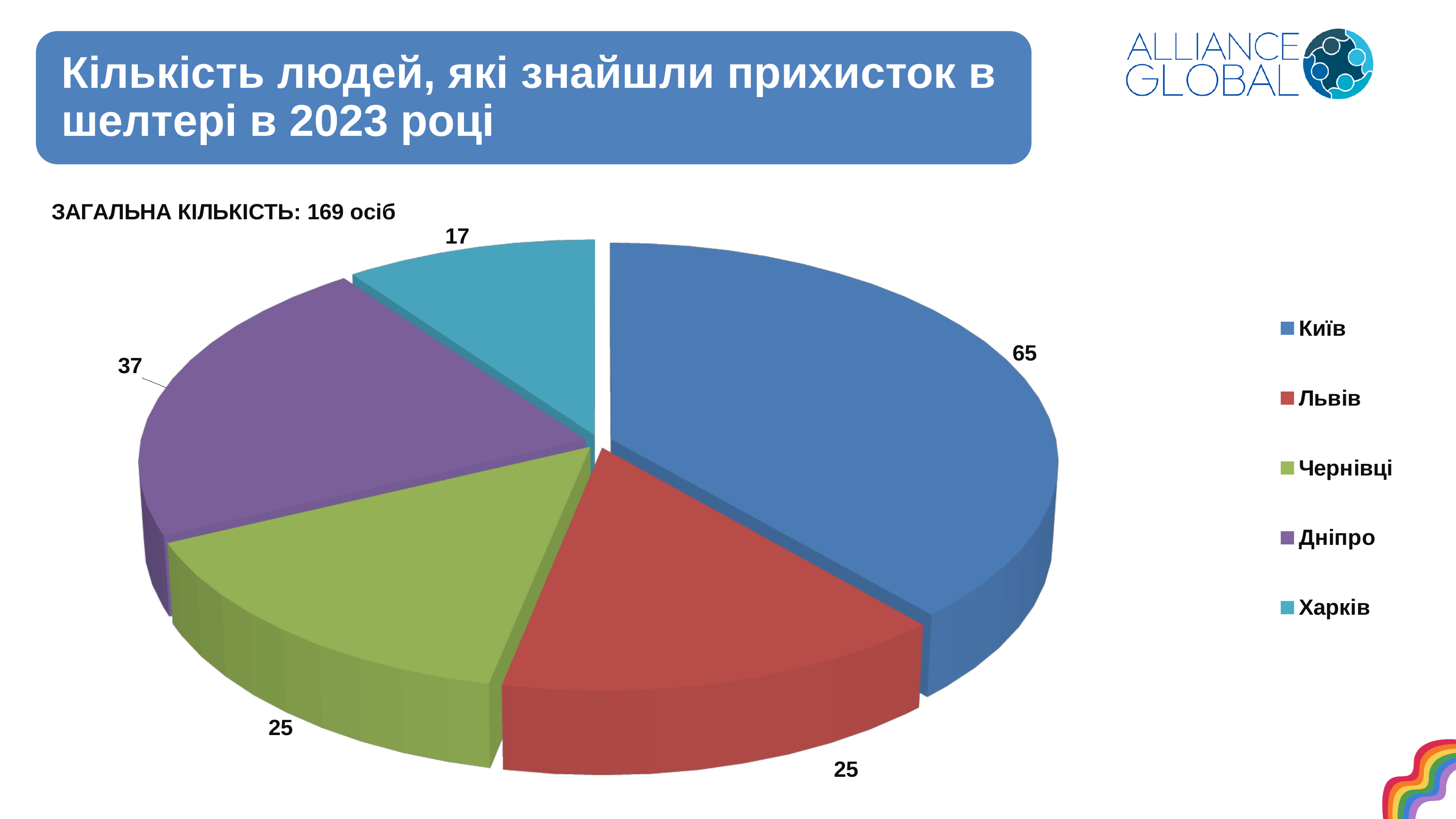
How many people found shelter in Київ according to the chart? 65 What total number of people is stated above the chart? 169 осіб What is the difference between the values for Дніпро and Харків? 20 Which is larger, the value for Дніпро or the value for Чернівці? Дніпро What kind of chart is shown on the slide? pie chart Which city has the smallest slice of the pie? Харків Which city has the largest slice of the pie? Київ What is the value shown for Харків? 17 What is the value shown for Дніпро? 37 How many cities (slices) does the pie chart show? 5 What is the value shown for Львів? 25 What is the difference between the values for Київ and Дніпро? 28